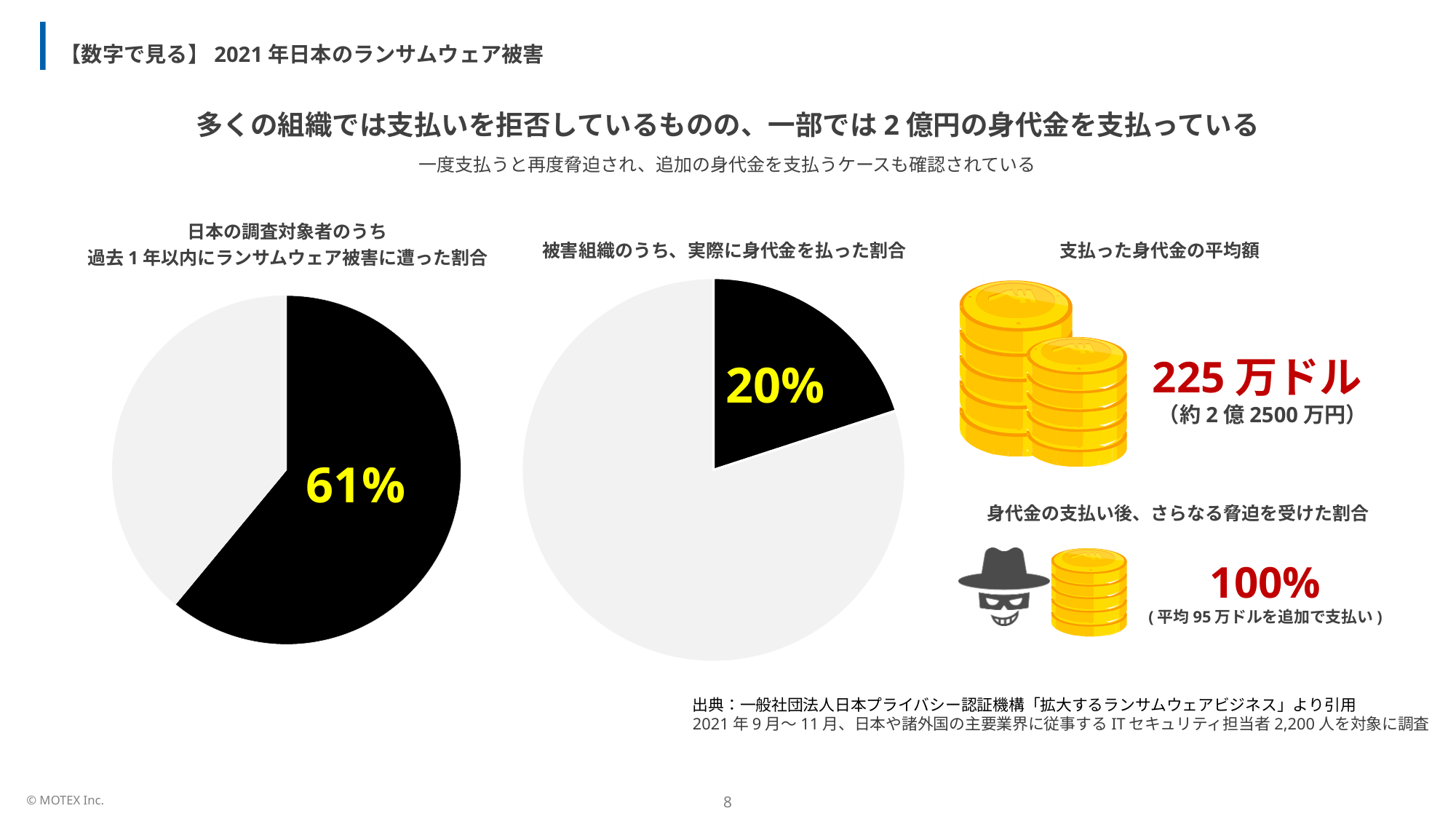
What is the difference between the labeled value in the left pie chart (61%) and the labeled value in the right pie chart (20%)? 41 percentage points What colour is used for the highlighted slice in both pie charts? Black What kind of chart is used to show the share of victim organizations that actually paid a ransom? Pie chart In the right pie chart, is the black slice greater or less than 50% of the pie? less What kind of chart is used to show the share of Japanese respondents hit by ransomware in the past year? Pie chart In the left pie chart, is the black slice greater or less than 50% of the pie? greater Which pie chart has the larger black slice, the left one (被害に遭った割合) or the right one (身代金を払った割合)? The left one (61%) In the right pie chart, what share of the pie does the grey (remaining) slice represent? 80% In the left pie chart (日本の調査対象者のうち過去1年以内にランサムウェア被害に遭った割合), what percentage is shown on the black slice? 61% In the right pie chart (被害組織のうち、実際に身代金を払った割合), what percentage is shown on the black slice? 20% In the left pie chart, what share of the pie does the grey (remaining) slice represent? 39% How many pie charts are on the slide? 2